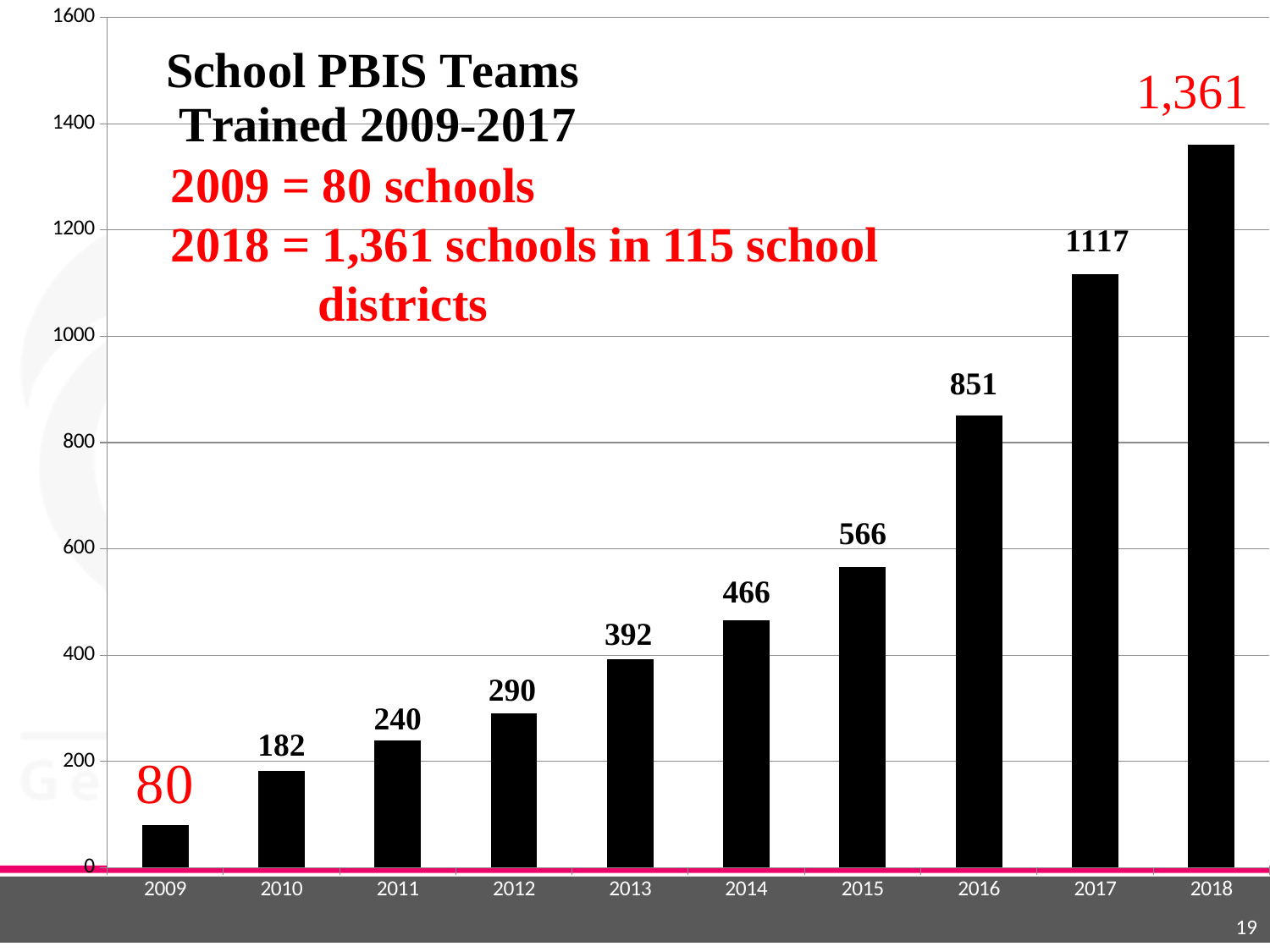
What is the value for 2016? 851 Which year has the lowest value? 2009 What is the difference between the values for 2015 and 2014? 100 How many years are shown on the x axis? 10 What is the value for 2013? 392 Which is larger, the value for 2012 or the value for 2011? 2012 What kind of chart is this? bar chart Do the values rise or fall from 2009 to 2018? rise What is the value for 2010? 182 Is the value for 2017 greater or less than 1000? greater Which year has the highest value? 2018 What is the difference between the values for 2017 and 2016? 266